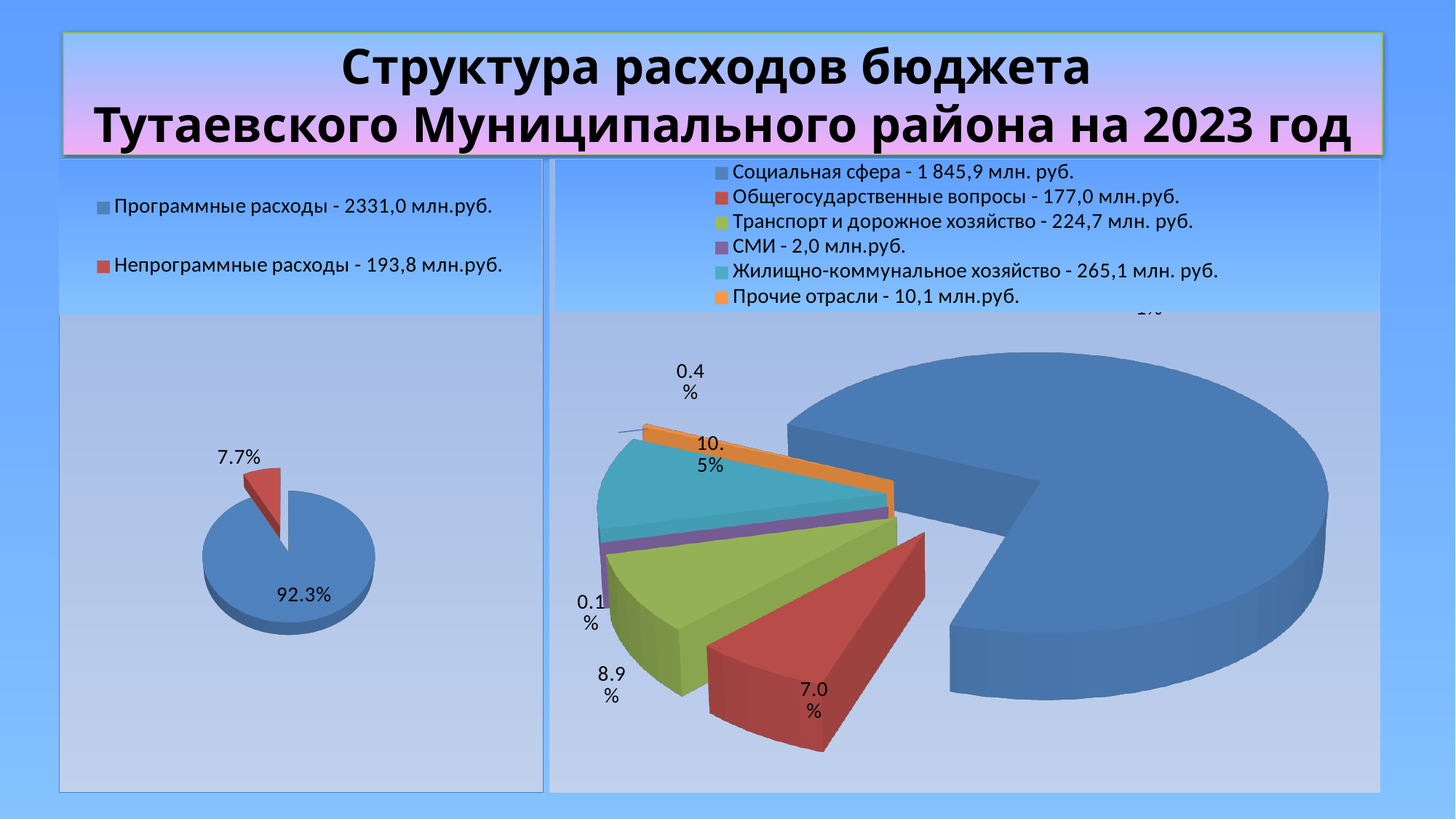
On the right pie chart, which category has the smallest slice? СМИ On the left pie chart, how many slices does the pie have? 2 On the right pie chart, what amount does the legend give for СМИ? 2,0 млн.руб. On the right pie chart, what share of the pie is Жилищно-коммунальное хозяйство? 10.5% On the right pie chart, which category has the largest slice? Социальная сфера On the left pie chart, what share of the pie is Программные расходы? 92.3% On the left pie chart, what share of the pie is Непрограммные расходы? 7.7% What kind of chart is shown on the left side of the slide? Pie chart On the right pie chart, how many categories does the legend list? 6 On the left pie chart, what amount does the legend give for Программные расходы? 2331,0 млн.руб.